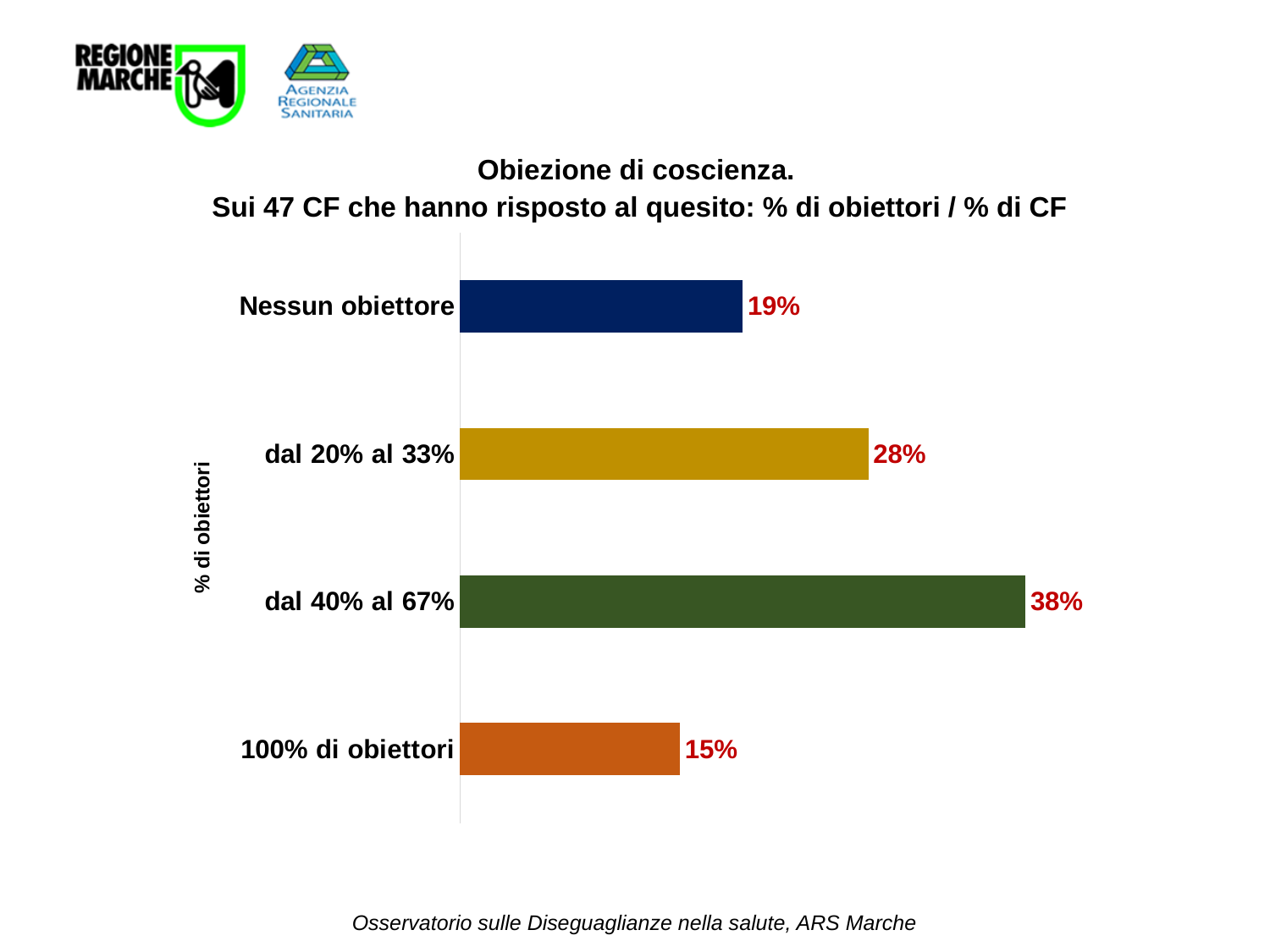
What kind of chart is shown on the slide? Bar chart What is the label on the vertical axis of the chart? % di obiettori What is the value for "dal 40% al 67%"? 38% Which category has the lowest value? 100% di obiettori Which is larger, the value for "dal 20% al 33%" or the value for "Nessun obiettore"? dal 20% al 33% What is the value for "100% di obiettori"? 15% What is the difference between the values for "dal 40% al 67%" and "dal 20% al 33%"? 10% How many categories are shown in the chart? 4 What is the difference between the values for "Nessun obiettore" and "100% di obiettori"? 4% Which category has the highest value? dal 40% al 67% What is the value for "Nessun obiettore"? 19% What is the value for "dal 20% al 33%"? 28%